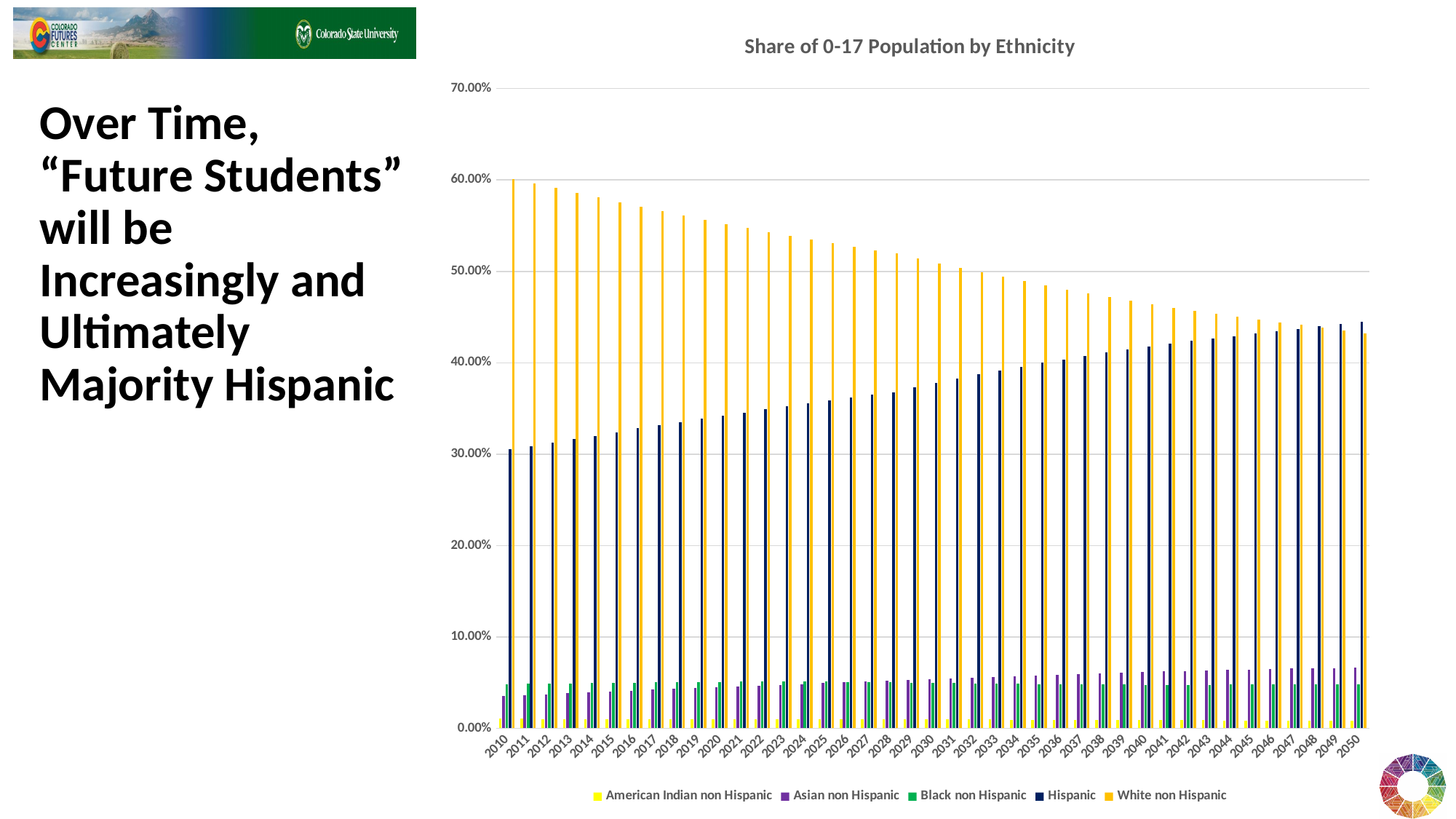
What kind of chart is shown on the slide? bar chart Which ethnicity has the lowest share of the 0-17 population in 2010? American Indian non Hispanic Does the share for Hispanic rise or fall from 2010 to 2050? rise Is the share for Hispanic in 2050 greater or less than 40.00%? greater Is the share for White non Hispanic in 2020 greater or less than 50.00%? greater Does the share for White non Hispanic rise or fall from 2010 to 2050? fall How many series does the chart legend list? 5 Which ethnicity has the highest share of the 0-17 population in 2010? White non Hispanic In 2010, which is larger: the share for White non Hispanic or the share for Hispanic? White non Hispanic Is the share for White non Hispanic in 2050 greater or less than 50.00%? less How many years are shown along the x axis of the chart? 41 What is the title of the chart? Share of 0-17 Population by Ethnicity